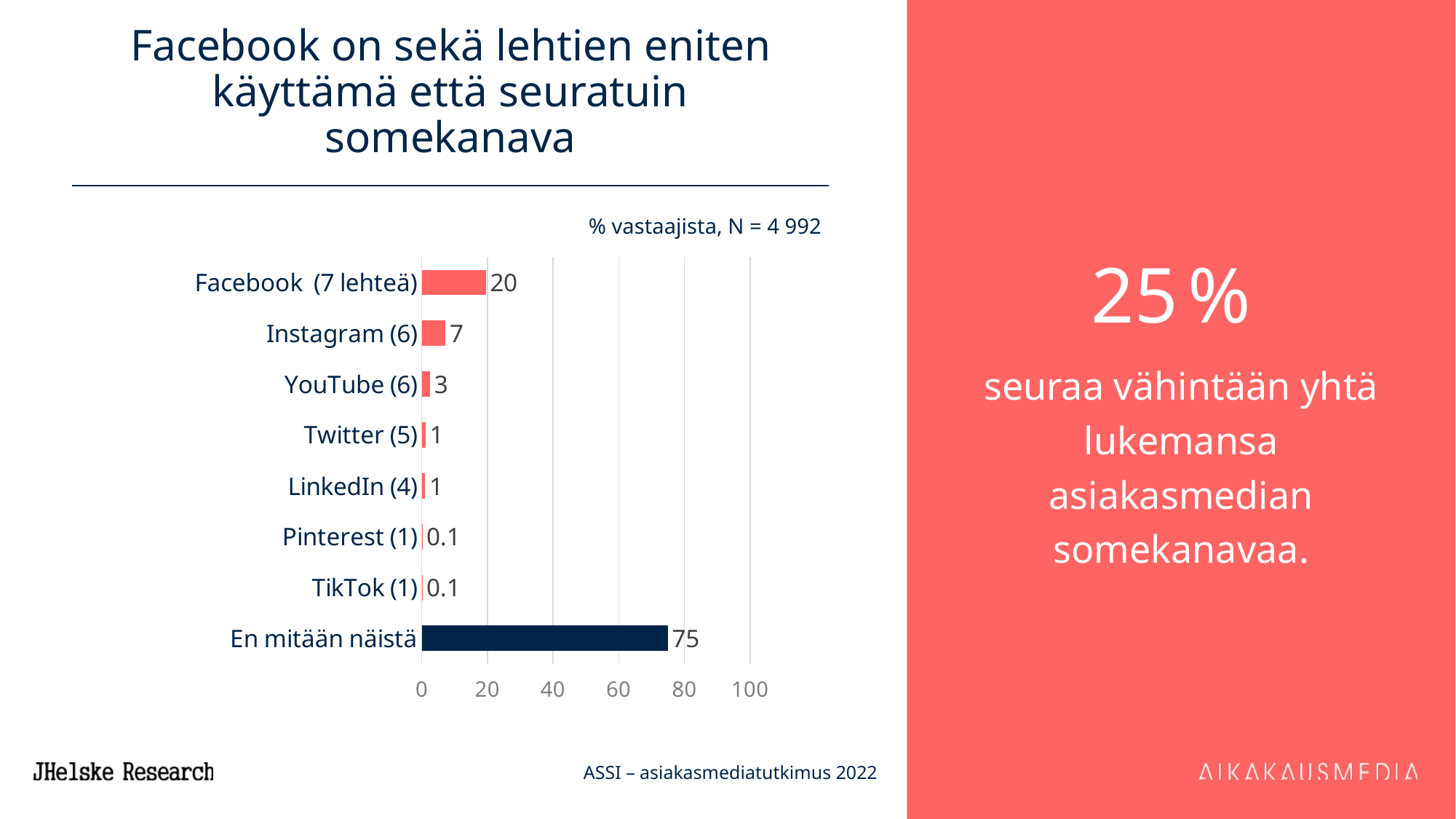
What is the value for Instagram (6)? 7 Which is larger, the value for Instagram (6) or the value for YouTube (6)? Instagram (6) Which category has the highest value? En mitään näistä What kind of chart is shown on the slide? bar chart How many categories are shown in the chart? 8 What is the difference between the values for Facebook (7 lehteä) and Instagram (6)? 13 Is the value for En mitään näistä greater or less than 60? greater What is the difference between the values for En mitään näistä and Facebook (7 lehteä)? 55 What is the value for YouTube (6)? 3 What is the value for En mitään näistä? 75 What is the value for Pinterest (1)? 0.1 What is the value for Facebook (7 lehteä)? 20